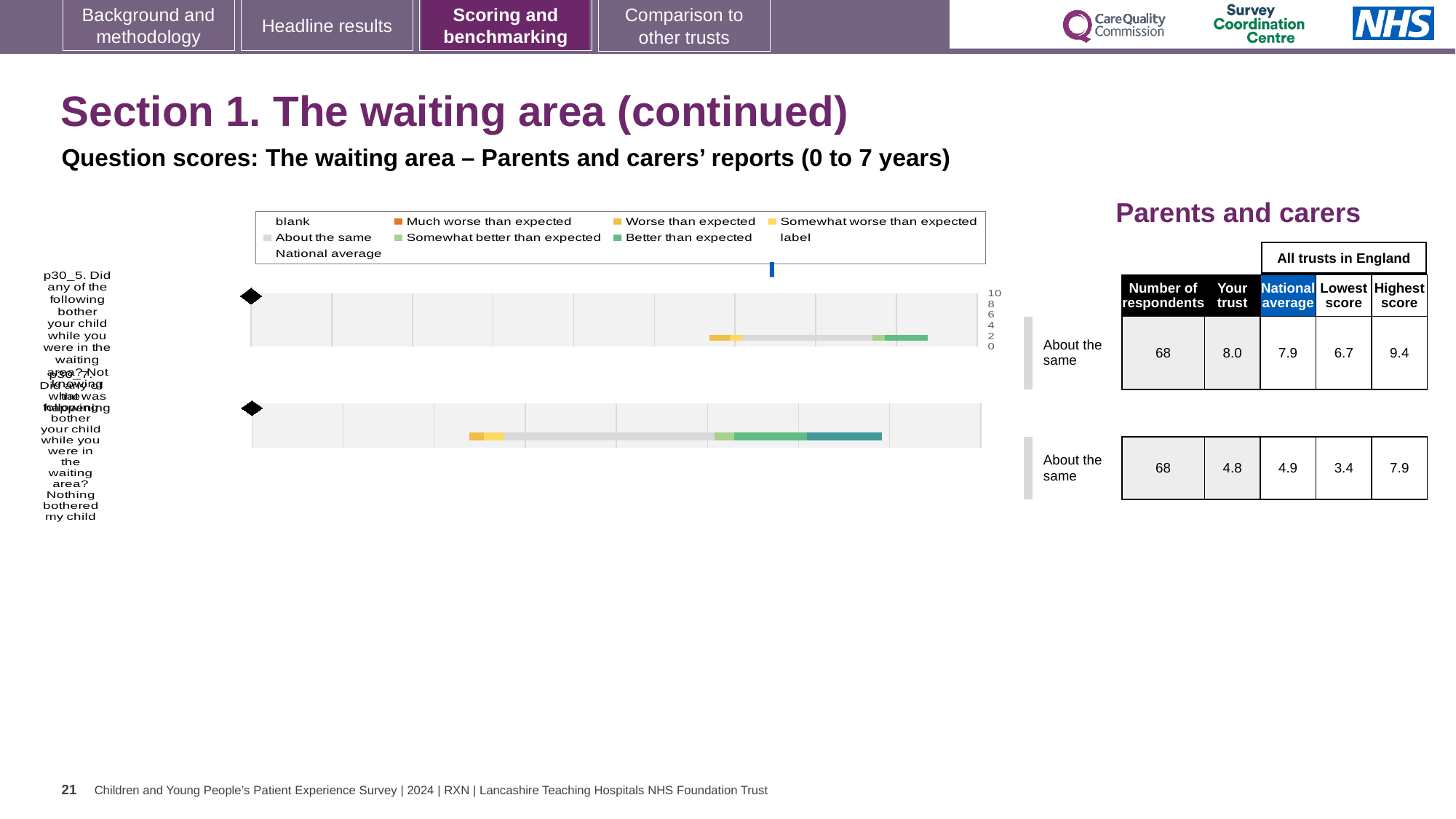
What is the 'Your trust' score for question p30_7 (Nothing bothered my child)? 4.8 How many respondents answered question p30_5? 68 How many question bars are plotted in the chart? 2 What is the 'Your trust' score for question p30_5 (Did any of the following bother your child while you were in the waiting area? Not knowing what was happening)? 8.0 What is the national average for question p30_5? 7.9 What is the difference between the highest score and the lowest score for question p30_5? 2.7 What colour does the legend use for 'About the same'? grey Which benchmark category is the trust placed in for both questions? About the same For question p30_7, which is larger: the 'Your trust' score or the national average? National average What kind of chart is shown on the slide? bar chart How many entries does the chart legend list? 9 What is the lowest score across all trusts in England for question p30_7? 3.4